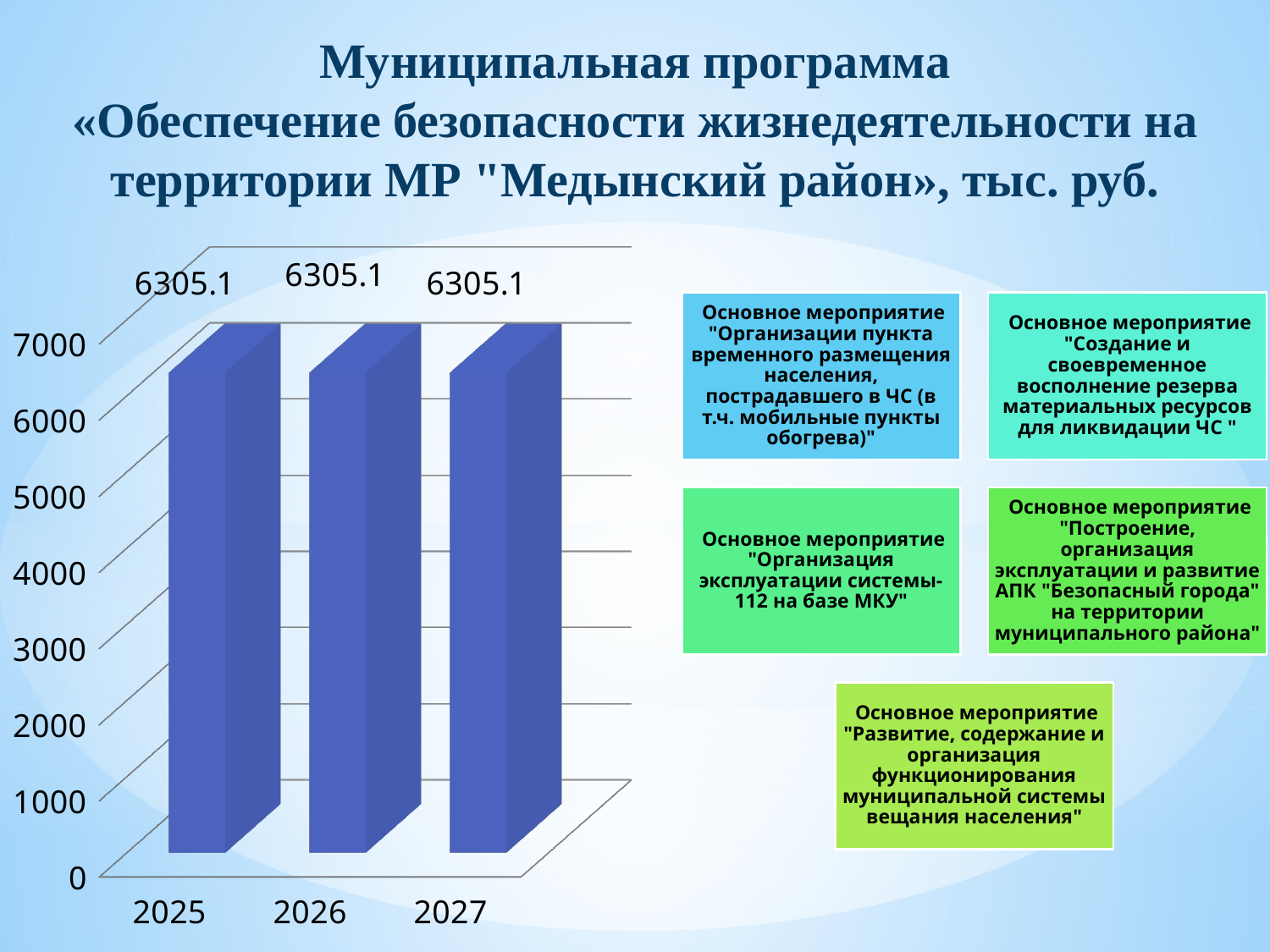
Is the value for 2027 greater or less than 7000? less What is the value for 2025? 6305.1 Do the values rise, fall or stay the same from 2025 to 2027? stay the same How many years are shown on the x axis of the chart? 3 What is the highest value shown on the vertical axis of the chart? 7000 Is the value for 2026 greater or less than 6000? greater What is the difference between the values for 2027 and 2025? 0 What is the value for 2026? 6305.1 What unit of measurement is stated in the slide title for the chart values? тыс. руб. What is the value for 2027? 6305.1 What kind of chart is shown on the slide? bar chart